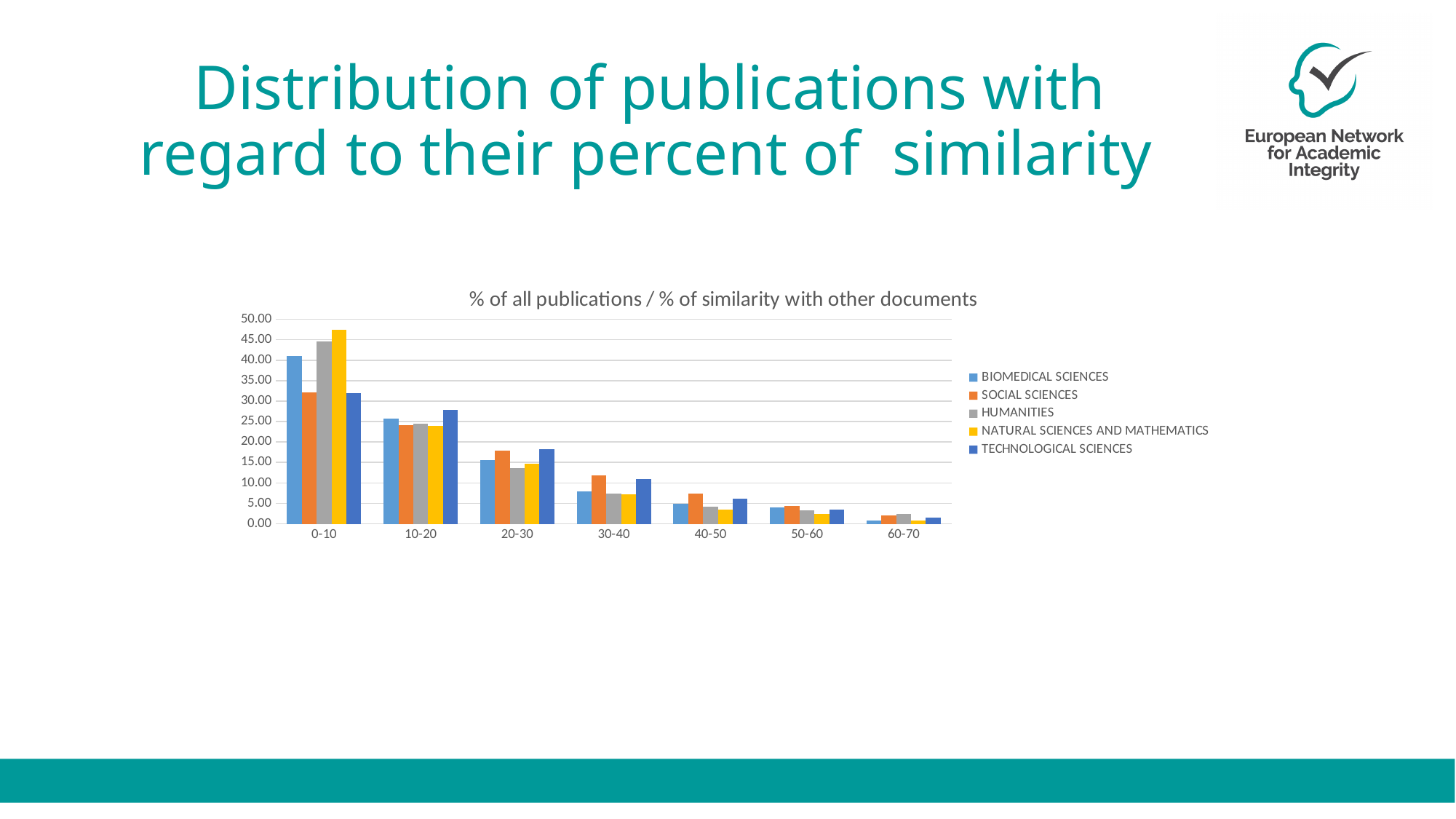
What kind of chart is shown on the slide? bar chart Is the value for BIOMEDICAL SCIENCES in the 0-10 range greater or less than 35.00? greater In the 0-10 similarity range, which series has the highest value? NATURAL SCIENCES AND MATHEMATICS In the 10-20 similarity range, which series has the highest value? TECHNOLOGICAL SCIENCES Is the value for TECHNOLOGICAL SCIENCES in the 10-20 range greater or less than 25.00? greater How many series does the legend list? 5 In the 0-10 range, which is larger: BIOMEDICAL SCIENCES or SOCIAL SCIENCES? BIOMEDICAL SCIENCES Is the value for SOCIAL SCIENCES in the 30-40 range greater or less than 10.00? greater What is the title of the chart? % of all publications / % of similarity with other documents Do the values for BIOMEDICAL SCIENCES rise or fall as the similarity range increases from 0-10 to 60-70? fall How many similarity ranges are shown on the x axis? 7